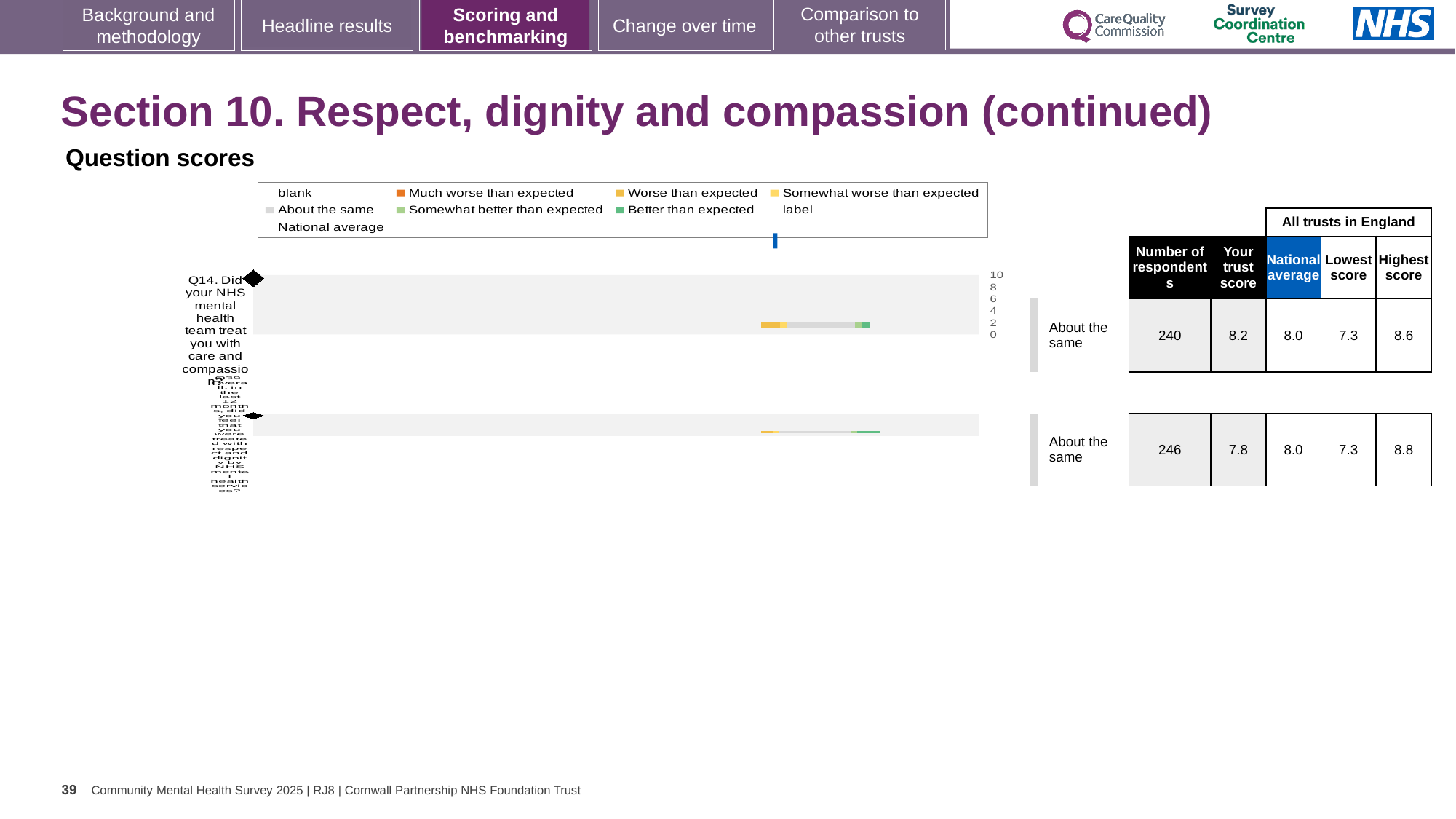
How many questions (rows) are plotted in the question scores chart? 2 Which question has the higher trust score, Q14 or Q39? Q14 What is the difference between the trust scores for Q14 and Q39? 0.4 How many respondents answered Q14? 240 What is the trust score for Q39 (respect and dignity) shown next to the chart? 7.8 What benchmark category is shown for Q14 in the chart? About the same What is the trust score for Q14 (care and compassion) shown next to the chart? 8.2 What is the difference between the highest and lowest trust scores in England for Q14? 1.3 How many respondents answered Q39? 246 What is the highest score among all trusts in England for Q39? 8.8 What is the national average score for Q14? 8.0 What kind of chart is used to show the question scores on this slide? bar chart